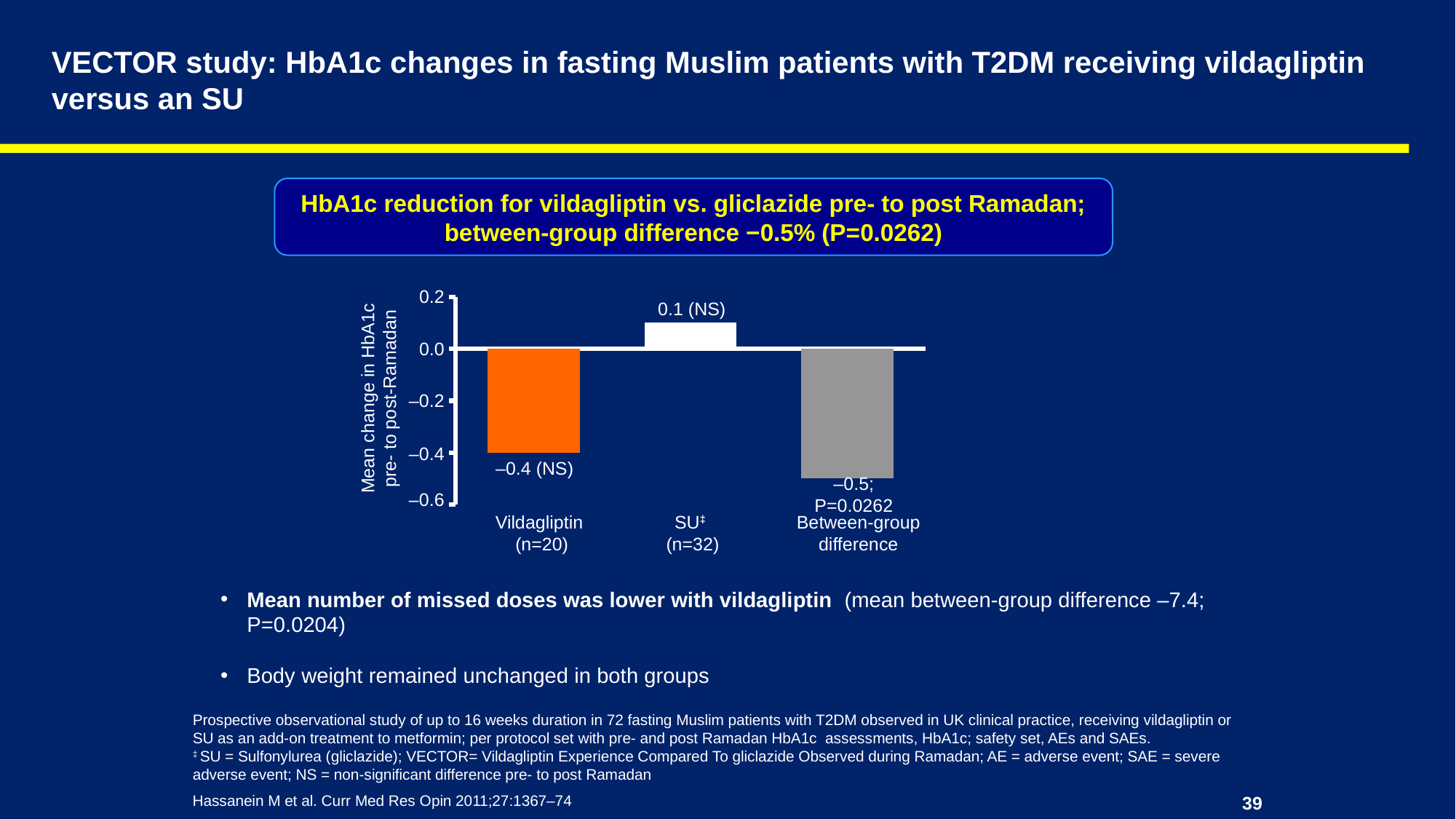
What is the label of the vertical axis? Mean change in HbA1c pre- to post-Ramadan What is the mean change in HbA1c for the Vildagliptin (n=20) group? –0.4 What value is shown for the Between-group difference bar? –0.5 What is the mean change in HbA1c for the SU (n=32) group? 0.1 What kind of chart is shown on the slide? Bar chart Which bar shows the highest value? SU (n=32) What is the difference between the SU value and the Vildagliptin value? 0.5 How many bars are plotted in the chart? 3 What colour is the Vildagliptin bar? Orange Which is larger, the value for Vildagliptin or the value for SU? SU Which bar shows the lowest value? Between-group difference What P value is printed next to the Between-group difference bar? P=0.0262